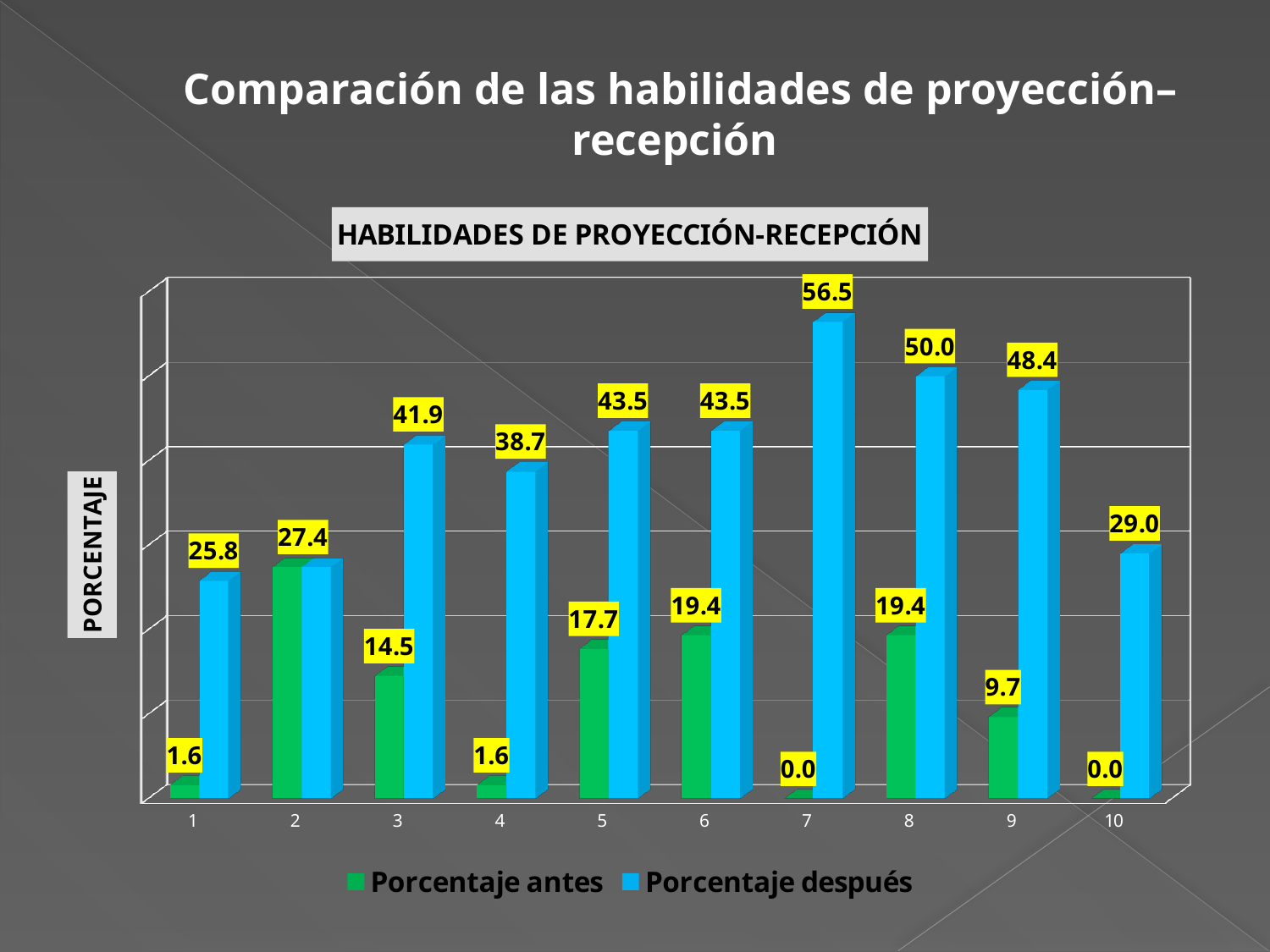
What kind of chart is shown on the slide? Bar chart Which category has the highest Porcentaje después value? 7 What is the value of Porcentaje antes for category 3? 14.5 Which category has the highest Porcentaje antes value? 2 How many series does the legend list? 2 What is the value of Porcentaje antes for category 9? 9.7 What is the difference between Porcentaje después and Porcentaje antes for category 9? 38.7 What is the value of Porcentaje después for category 7? 56.5 How many categories are shown on the x axis? 10 Which category has the lowest Porcentaje después value? 1 What is the value of Porcentaje después for category 10? 29.0 Which is larger for category 5: Porcentaje antes or Porcentaje después? Porcentaje después